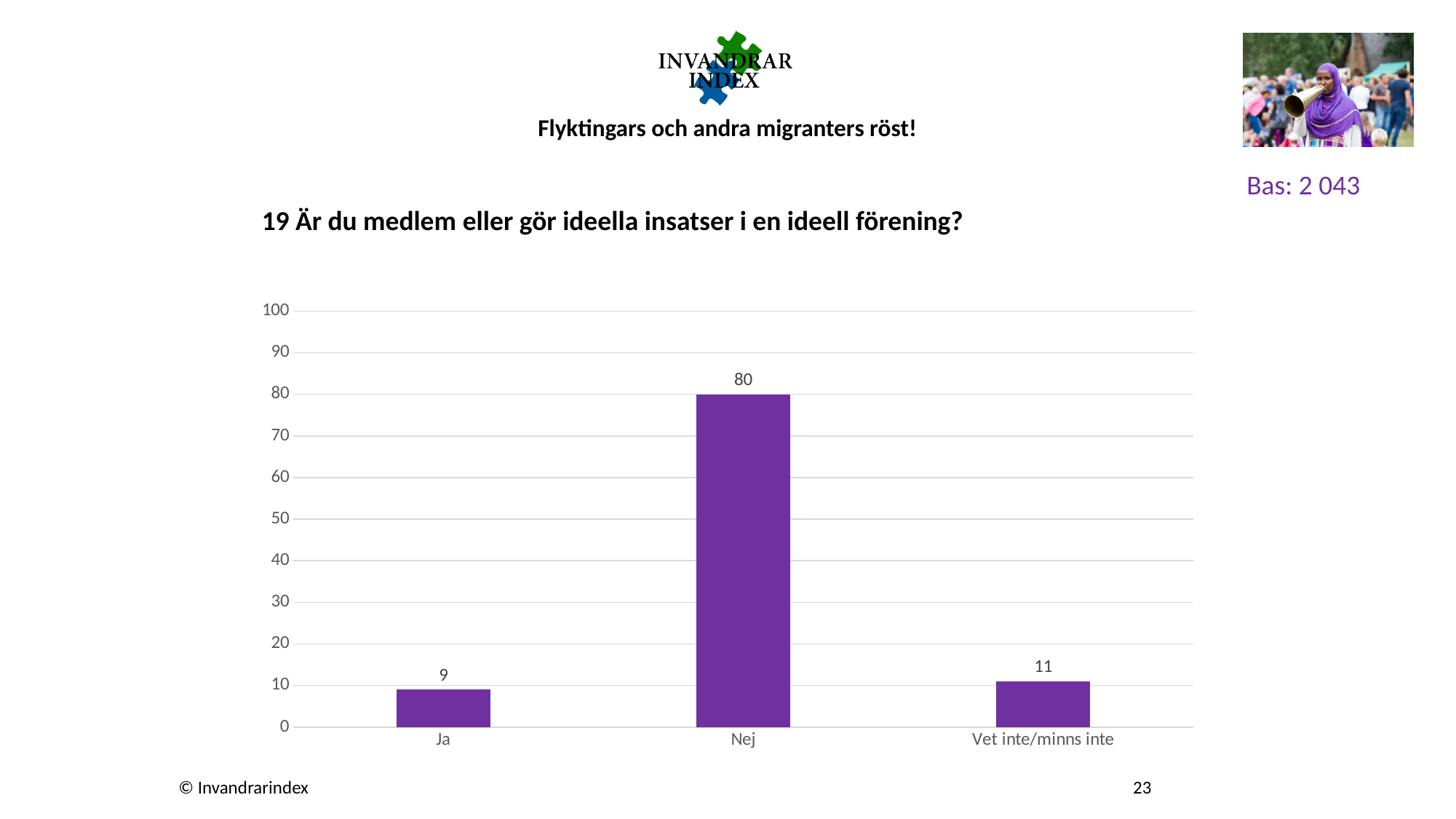
What is the value for "Nej"? 80 What is the value for "Ja"? 9 Which category has the highest value? Nej How many categories are shown on the x axis? 3 Is the value for "Nej" greater or less than 50? greater Which is larger, the value for "Ja" or the value for "Vet inte/minns inte"? Vet inte/minns inte What is the difference between the values for "Vet inte/minns inte" and "Ja"? 2 What is the difference between the values for "Nej" and "Ja"? 71 What is the title of the chart? 19 Är du medlem eller gör ideella insatser i en ideell förening? What is the value for "Vet inte/minns inte"? 11 What kind of chart is shown on the slide? bar chart Which category has the lowest value? Ja